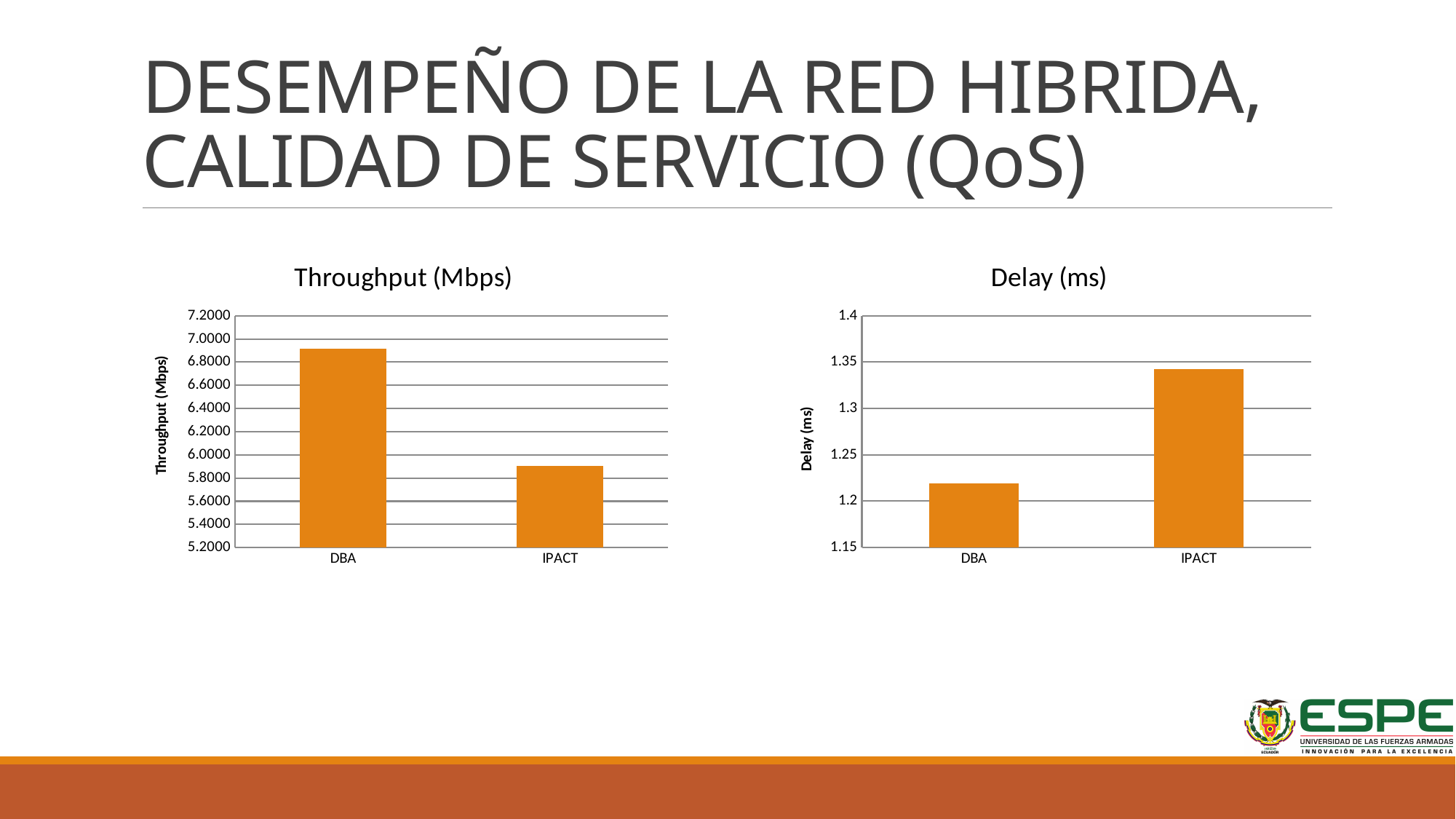
What kind of chart is the Delay (ms) chart? Bar chart In the Delay (ms) chart, which category has the lowest value? DBA In the Delay (ms) chart, which is larger, the value for DBA or the value for IPACT? IPACT How many categories are shown in the Throughput (Mbps) chart? 2 In the Delay (ms) chart, is the value for DBA greater or less than 1.25? less In the Throughput (Mbps) chart, is the value for IPACT greater or less than 6.0? less In the Throughput (Mbps) chart, which category has the highest value? DBA In the Throughput (Mbps) chart, which category has the lowest value? IPACT In the Delay (ms) chart, is the value for IPACT greater or less than 1.3? greater In the Delay (ms) chart, which category has the highest value? IPACT What is the y-axis label of the chart on the right? Delay (ms)